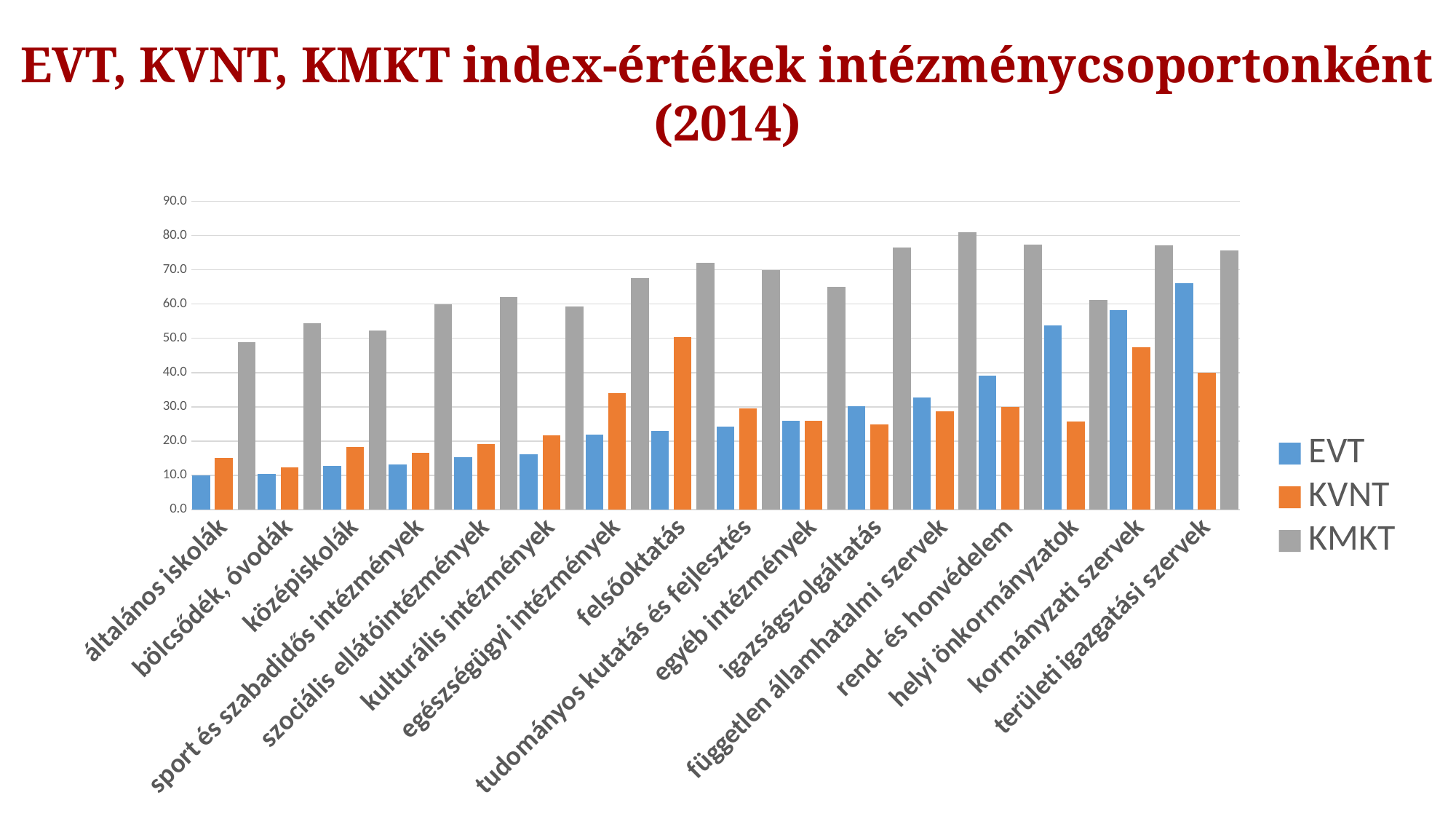
Do the EVT values generally rise or fall from left to right along the x axis? rise What kind of chart is shown on the slide? bar chart How many series does the legend list? 3 Which category has the lowest KMKT value? általános iskolák Is the EVT value for helyi önkormányzatok greater or less than 50? greater How many institution groups (categories) are shown on the x axis? 16 Is the KVNT value for felsőoktatás greater or less than 40? greater Which category has the highest KVNT value? felsőoktatás Which category has the highest EVT value? területi igazgatási szervek Is the KMKT value for általános iskolák greater or less than 50? less Which category has the highest KMKT value? független államhatalmi szervek For területi igazgatási szervek, which is larger, the EVT value or the KVNT value? EVT